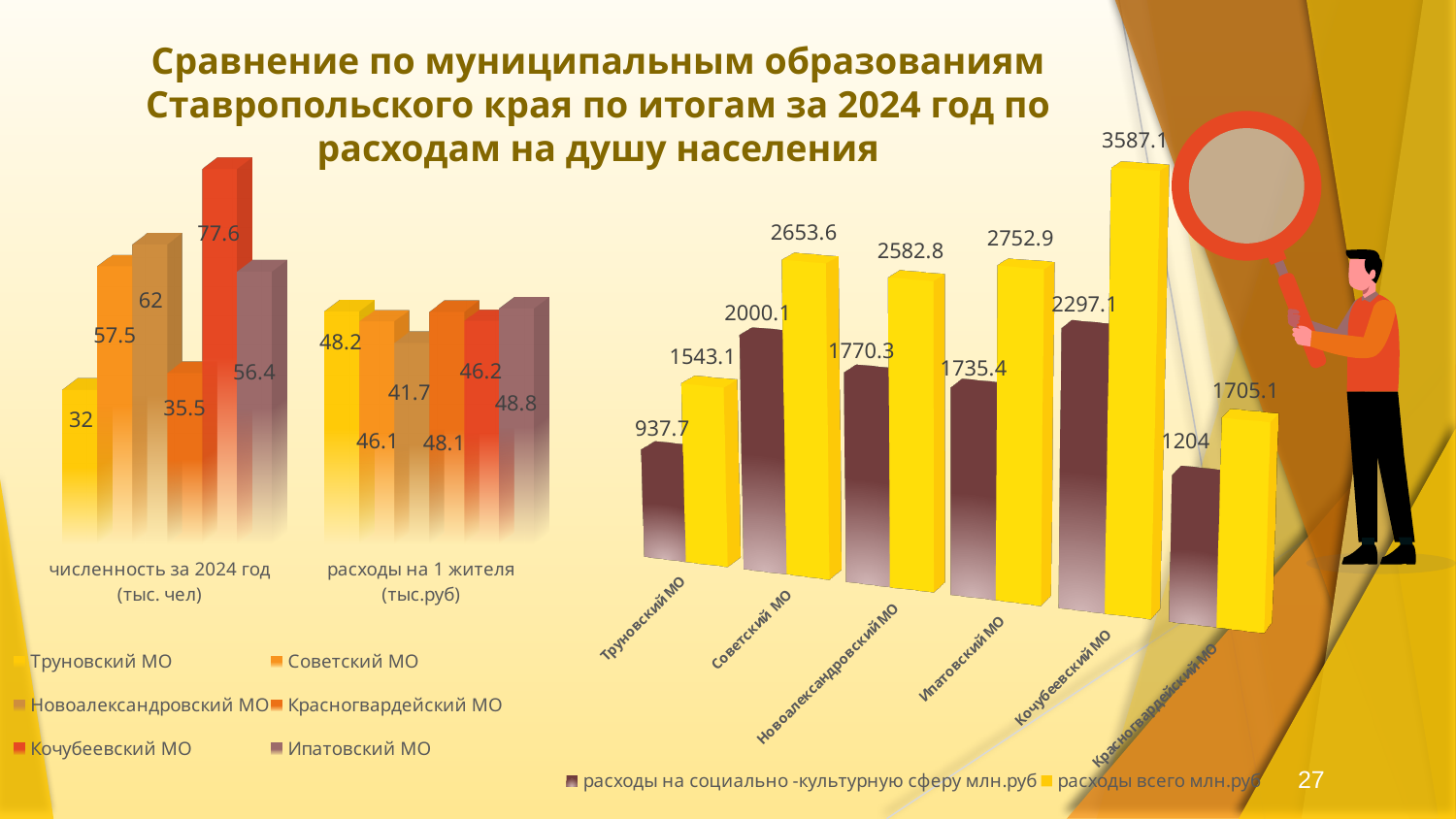
What kind of chart is the right chart? Bar chart On the right chart, what are the расходы на социально-культурную сферу млн.руб for Труновский МО? 937.7 On the left chart, which municipality has the lowest численность за 2024 год? Труновский МО On the left chart, which municipality has the highest численность за 2024 год? Кочубеевский МО On the right chart, what are the расходы всего млн.руб for Кочубеевский МО? 3587.1 On the right chart, which is larger: расходы всего for Советский МО or for Ипатовский МО? Ипатовский МО On the left chart, how many series does the legend list? 6 On the left chart, what is the расходы на 1 жителя (тыс.руб) for Новоалександровский МО? 41.7 On the left chart, what is the difference in численность за 2024 год between Новоалександровский МО and Красногвардейский МО? 26.5 On the right chart, which municipality has the lowest расходы всего млн.руб? Труновский МО On the left chart, what is the численность за 2024 год (тыс. чел) for Кочубеевский МО? 77.6 On the right chart, what is the difference between расходы всего and расходы на социально-культурную сферу for Красногвардейский МО? 501.1